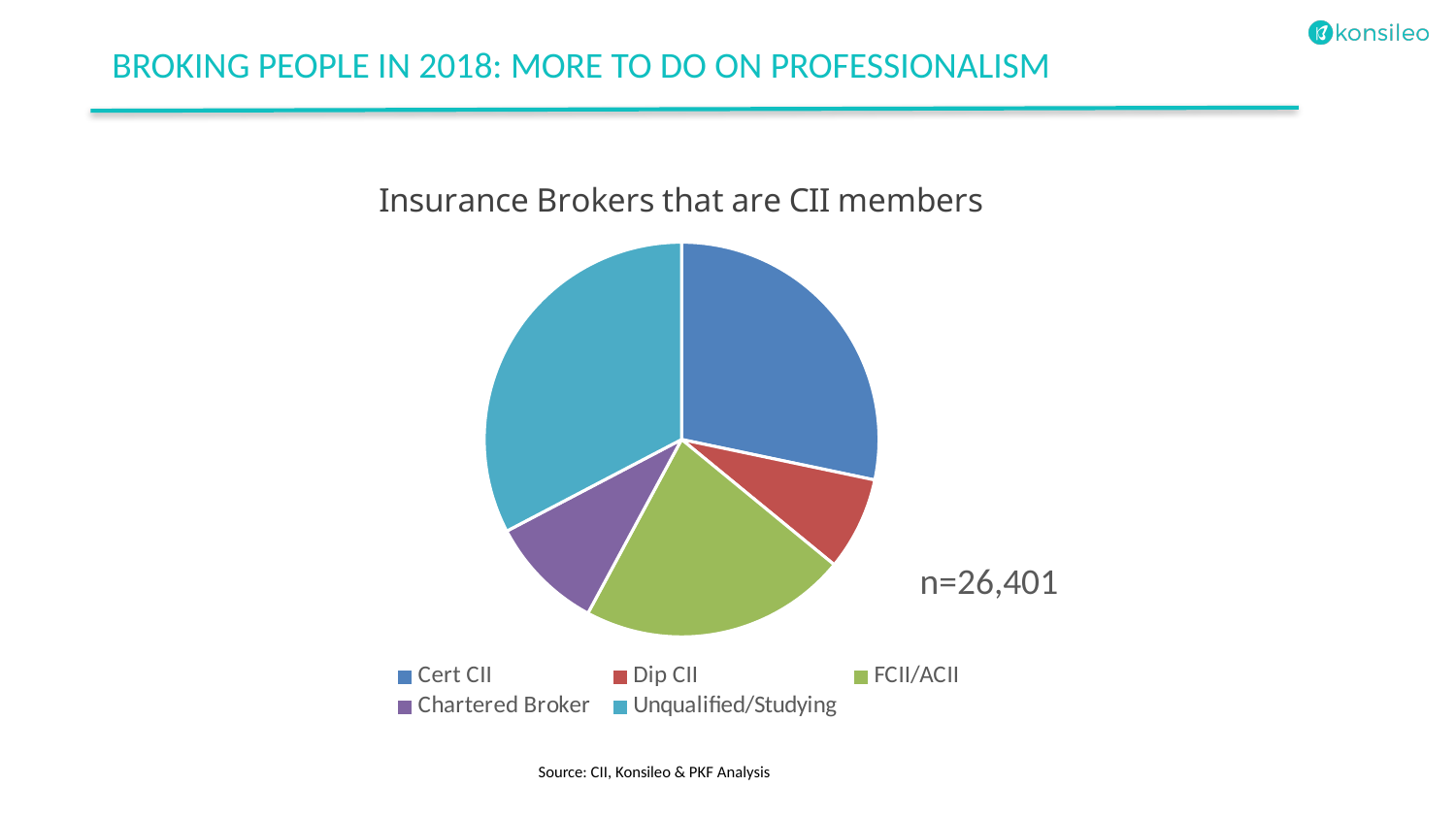
How many entries does the legend of the pie chart list? 5 Which slice is larger, FCII/ACII or Chartered Broker? FCII/ACII Which category has the largest slice of the pie chart? Unqualified/Studying Which slice is larger, Unqualified/Studying or Cert CII? Unqualified/Studying What kind of chart is shown on the slide? Pie chart Which category has the smallest slice of the pie chart? Dip CII How many slices does the pie chart have? 5 What is the title of the pie chart? Insurance Brokers that are CII members Which slice is larger, Dip CII or FCII/ACII? FCII/ACII What sample size (n) is shown next to the pie chart? n=26,401